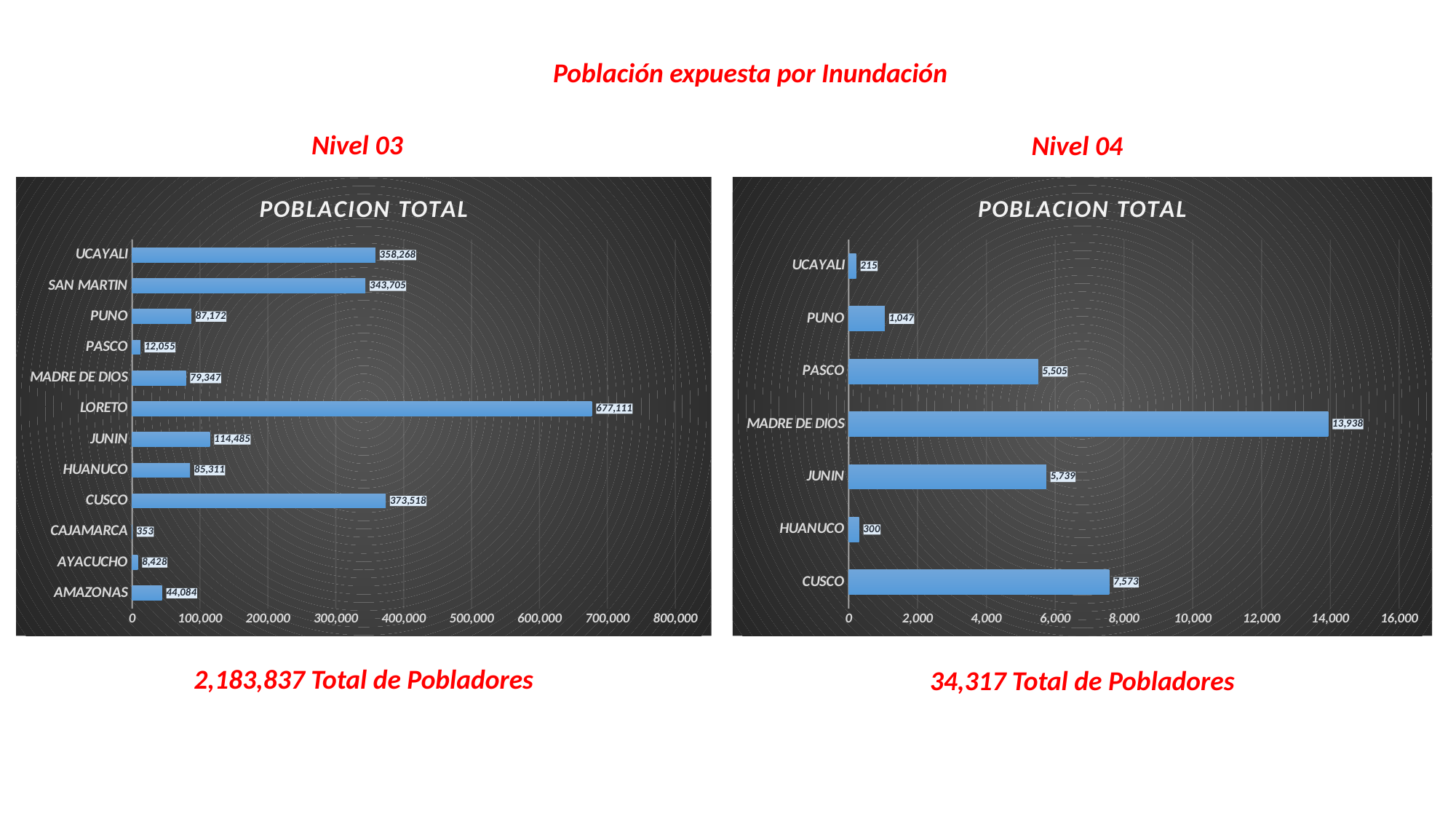
In the Nivel 04 chart (right), which category has the lowest value? UCAYALI In the Nivel 04 chart (right), what is the difference between the values for MADRE DE DIOS and CUSCO? 6,365 In the Nivel 03 chart (left), what is the value for LORETO? 677,111 In the Nivel 04 chart (right), which category has the highest value? MADRE DE DIOS In the Nivel 03 chart (left), what is the difference between the values for LORETO and CUSCO? 303,593 In the Nivel 03 chart (left), which category has the lowest value? CAJAMARCA In the Nivel 04 chart (right), which is larger, the value for JUNIN or the value for PASCO? JUNIN In the Nivel 04 chart (right), what is the value for PASCO? 5,505 How many categories are shown in the Nivel 03 chart (left)? 12 In the Nivel 03 chart (left), what is the value for SAN MARTIN? 343,705 In the Nivel 03 chart (left), which category has the highest value? LORETO What kind of chart is the Nivel 04 chart (right)? Bar chart